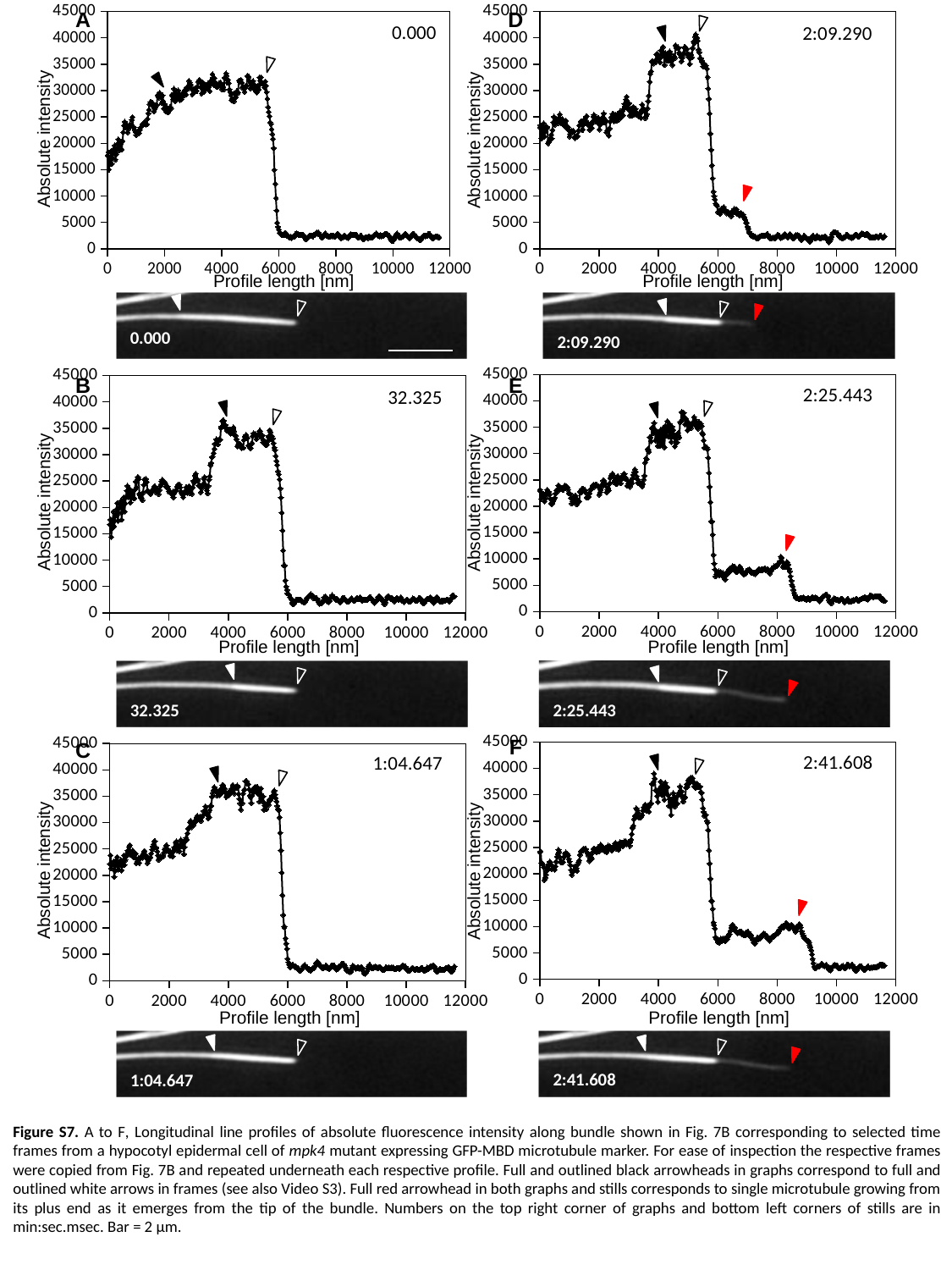
In chart D, is the value at a profile length of 4000 nm greater or less than 30000? greater How many line-profile charts are shown on the slide? 6 In chart A, is the value at a profile length of 8000 nm greater or less than 5000? less In chart B, is the value at a profile length of 2000 nm greater or less than 30000? less In chart C, do the values rise or fall between profile lengths of 5500 and 6500 nm? fall What time stamp is shown in the top right corner of chart F? 2:41.608 What is the y-axis label on chart A? Absolute intensity What kind of chart is chart A? line chart In chart A, which profile length has the larger value, 4000 nm or 8000 nm? 4000 nm In chart A, do the values rise or fall between profile lengths of 0 and 2000 nm? rise